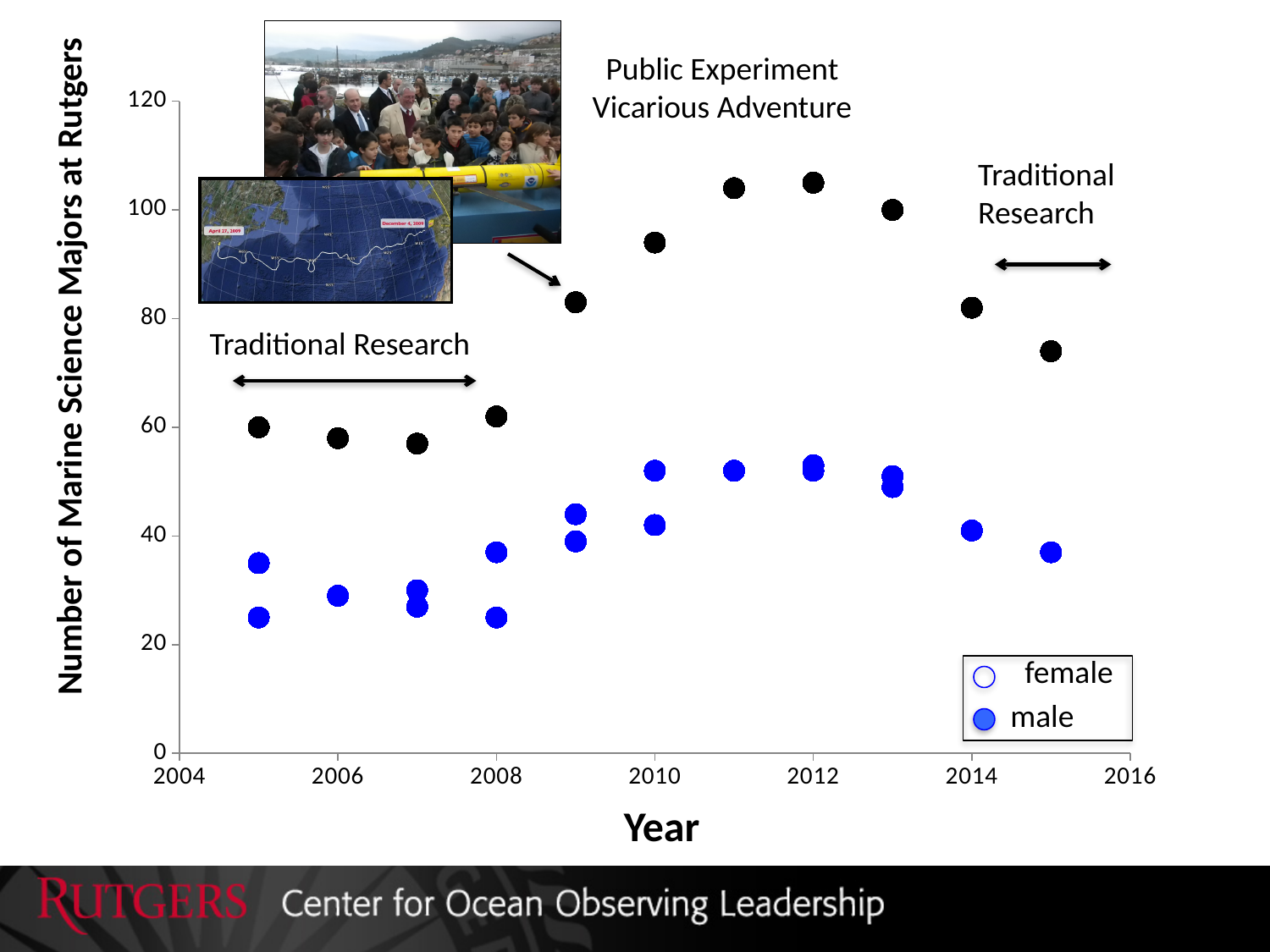
What is the title of the y axis? Number of Marine Science Majors at Rutgers Is the value of the black point for 2012 greater or less than 100? greater Is the higher blue point for 2011 greater or less than 40? greater Do the black points rise or fall from 2008 to 2012? rise What kind of chart is shown on the slide? scatter plot How many years have black data points plotted on the chart? 11 Is the value of the blue point for 2006 greater or less than 40? less What are the two entries in the chart's legend? female, male How many series does the legend list? 2 Which is larger, the black point for 2010 or the black point for 2015? 2010